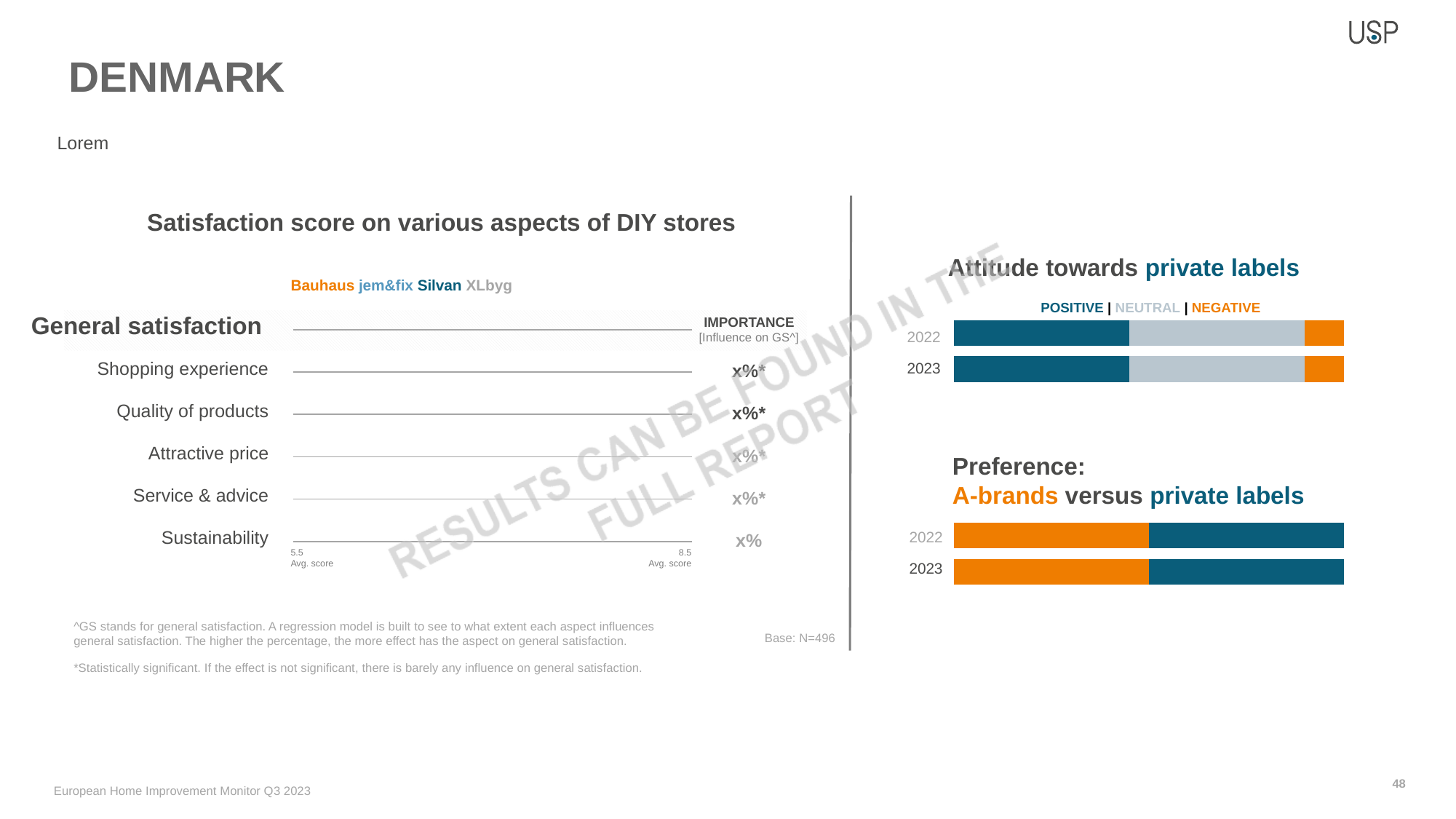
How many series does the 'Preference: A-brands versus private labels' chart show? 2 How many years are shown in the 'Attitude towards private labels' chart? 2 What is the base (N) stated for the 'Satisfaction score on various aspects of DIY stores' chart? N=496 What is the lowest value shown on the Avg. score axis of the 'Satisfaction score on various aspects of DIY stores' chart? 5.5 What kind of chart is the 'Preference: A-brands versus private labels' chart? bar chart In the 'Attitude towards private labels' chart, which attitude has the smallest segment in 2023? Negative How many aspects are listed below 'General satisfaction' in the 'Satisfaction score on various aspects of DIY stores' chart? 5 How many series does the legend of the 'Satisfaction score on various aspects of DIY stores' chart list? 4 What kind of chart is the 'Attitude towards private labels' chart? bar chart In the 'Attitude towards private labels' chart, which segment is larger in 2022: Positive or Negative? Positive How many series does the legend of the 'Attitude towards private labels' chart list? 3